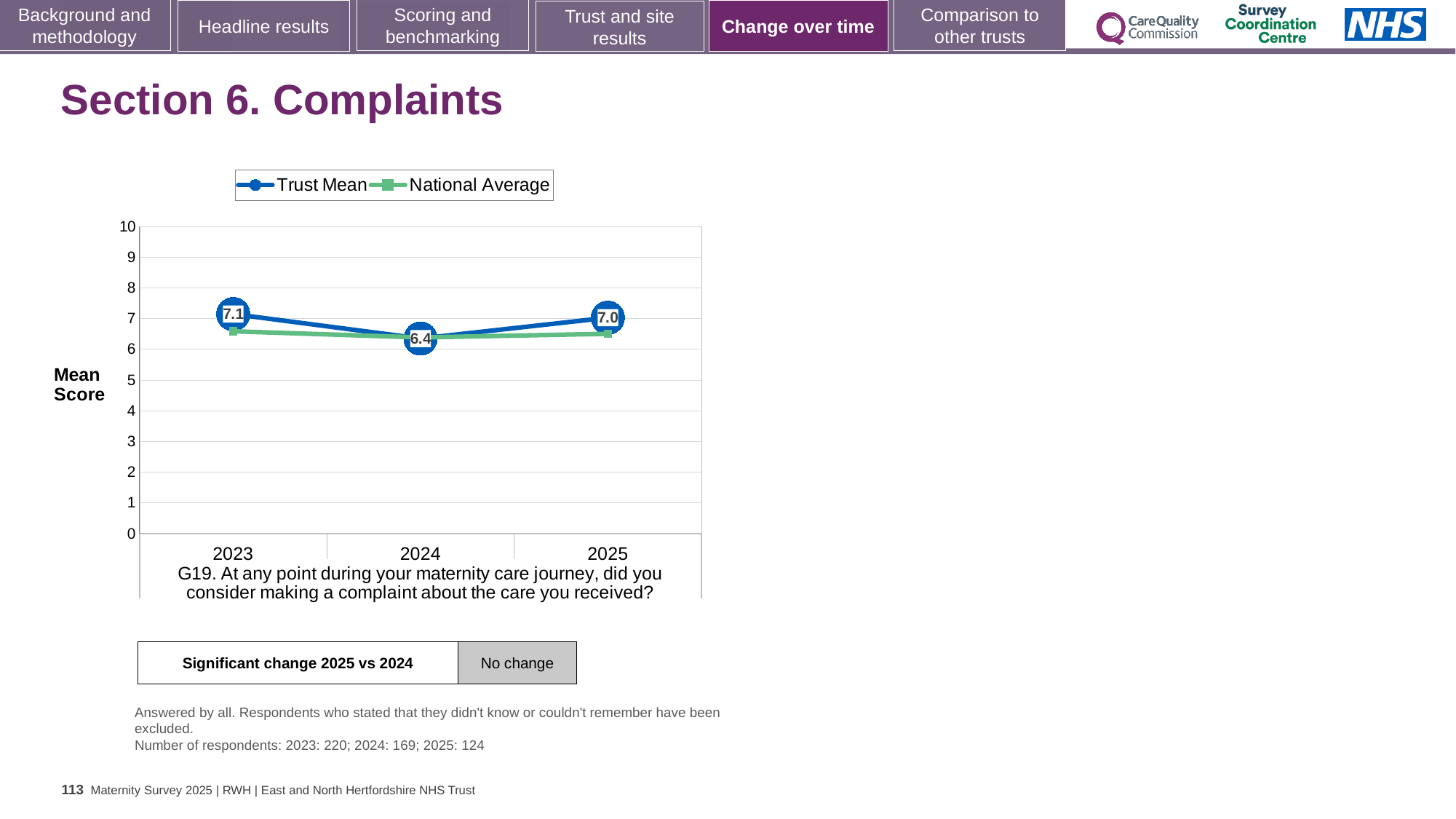
How many series does the chart legend list? 2 What is the Trust Mean score for 2024? 6.4 What is the difference between the Trust Mean scores for 2023 and 2024? 0.7 In which year is the Trust Mean score highest? 2023 What kind of chart is shown on the slide? Line chart How many years are shown on the x axis of the chart? 3 In which year is the Trust Mean score lowest? 2024 Is the National Average value for 2023 greater or less than 7? less What is the difference between the Trust Mean scores for 2025 and 2024? 0.6 What is the Trust Mean score for 2023? 7.1 Which year has the larger Trust Mean score, 2023 or 2025? 2023 What is the Trust Mean score for 2025? 7.0